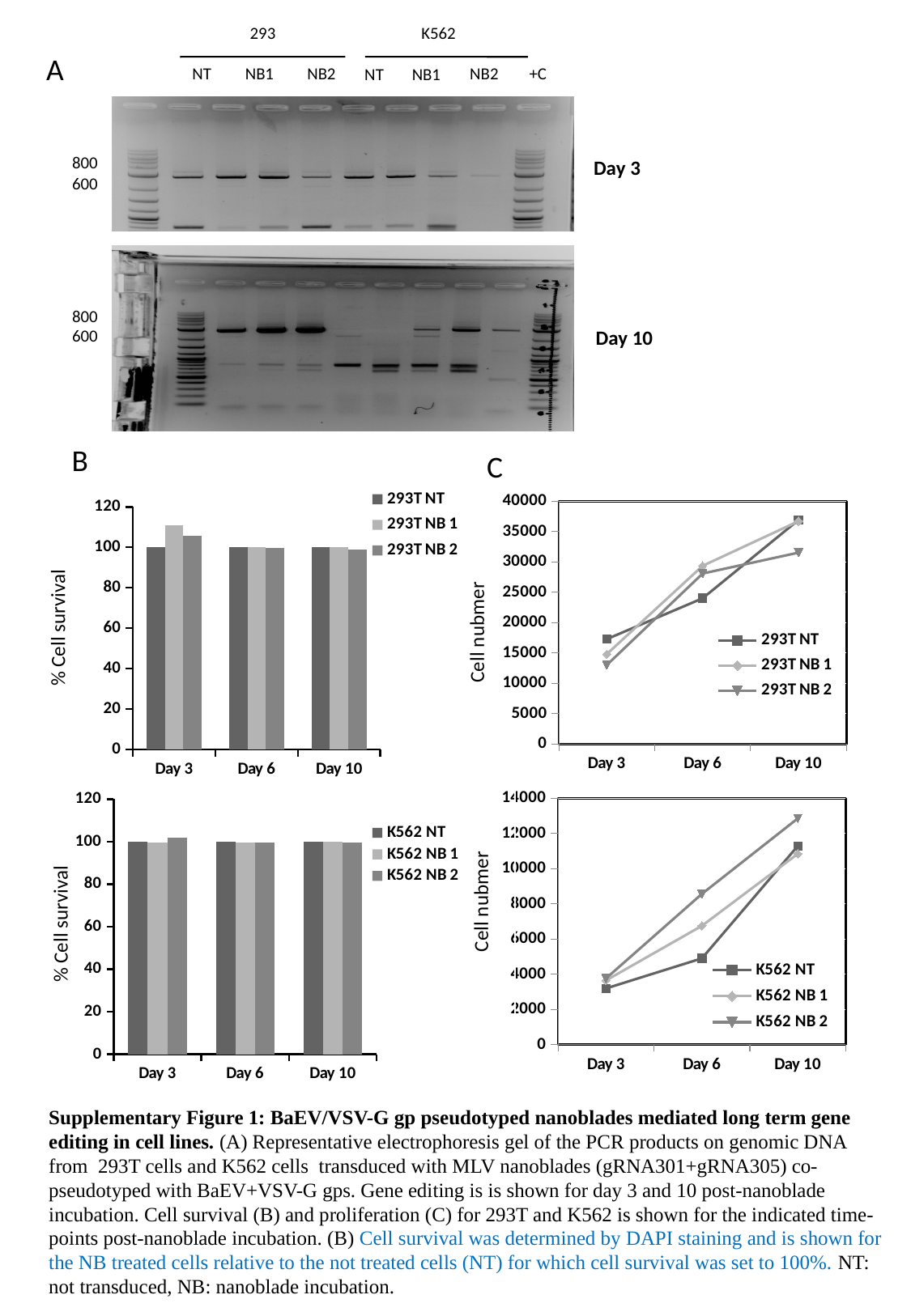
In the top chart of panel C (293T Cell number), at Day 6 which is larger, 293T NT or 293T NB 1? 293T NB 1 In the bottom chart of panel C (K562 Cell number), do the values for K562 NB 2 rise or fall from Day 3 to Day 10? rise In the bottom chart of panel C (K562 Cell number), which series has the highest value at Day 10? K562 NB 2 What kind of chart is the top chart of panel C (293T Cell number)? line chart In the top chart of panel B (293T % Cell survival), how many series does the legend list? 3 In the top chart of panel B (293T % Cell survival), which series has the highest value at Day 3? 293T NB 1 In the bottom chart of panel C (K562 Cell number), is the value for K562 NT at Day 6 greater or less than 6000? less What kind of chart is the bottom chart of panel B (K562 % Cell survival)? bar chart In the top chart of panel B (293T % Cell survival), is the value for 293T NB 1 at Day 3 greater or less than 100? greater In the bottom chart of panel B (K562 % Cell survival), how many time-point categories are shown on the x axis? 3 In the top chart of panel C (293T Cell number), which series has the highest value at Day 3? 293T NT In the top chart of panel C (293T Cell number), is the value for 293T NB 2 at Day 10 greater or less than 35000? less